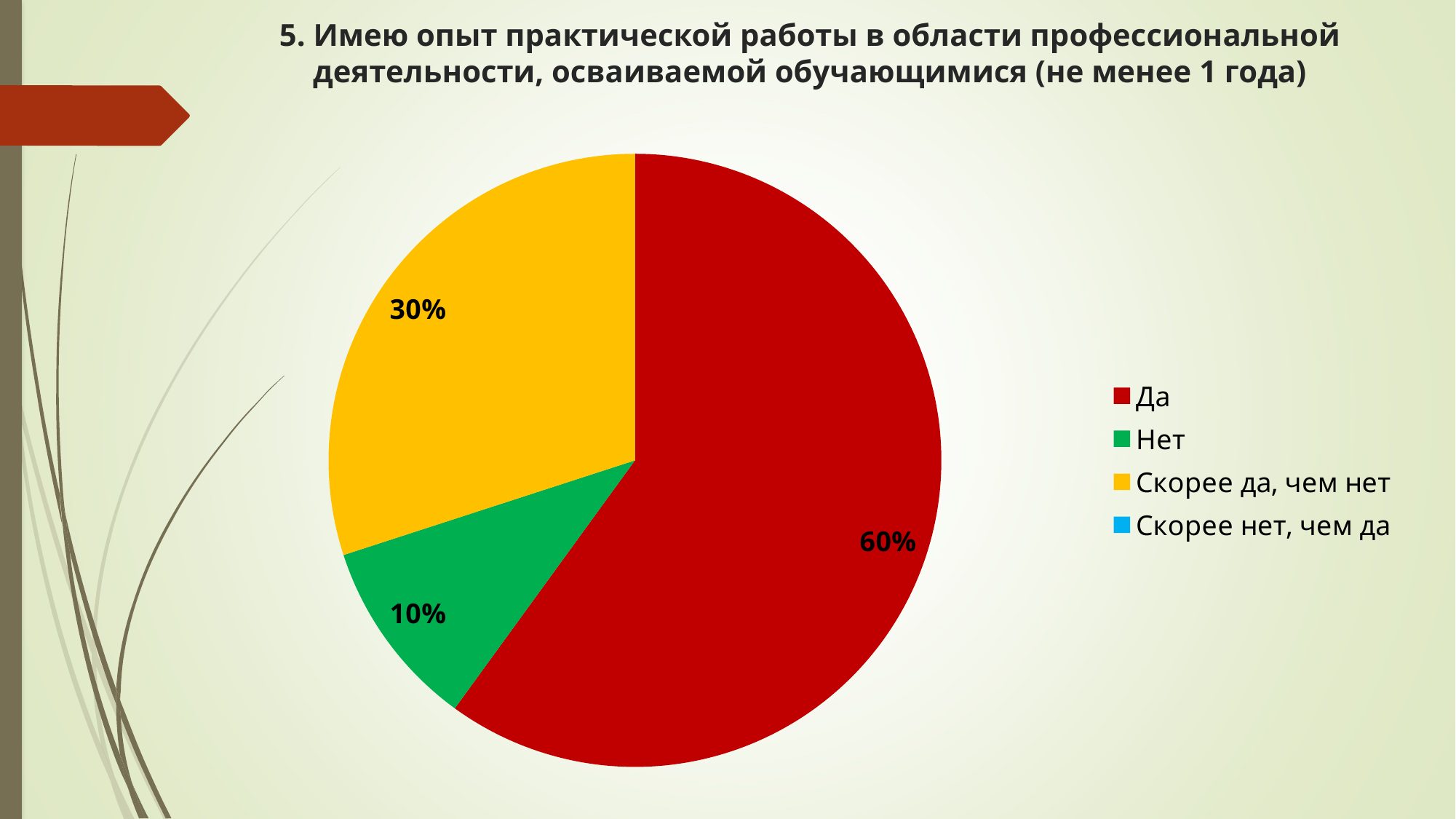
Which of the visible slices is the smallest? Нет How many entries does the legend list? 4 Which is larger, the share for "Нет" or the share for "Скорее да, чем нет"? Скорее да, чем нет Which category has the largest slice of the pie? Да What is the difference between the shares for "Скорее да, чем нет" and "Нет"? 20% What is the difference between the shares for "Да" and "Скорее да, чем нет"? 30% What share of the pie does "Нет" have? 10% What kind of chart is shown on the slide? pie chart What colour is the slice for "Да"? red Which legend entry has no visible slice in the pie? Скорее нет, чем да What share of the pie does "Да" have? 60% What share of the pie does "Скорее да, чем нет" have? 30%